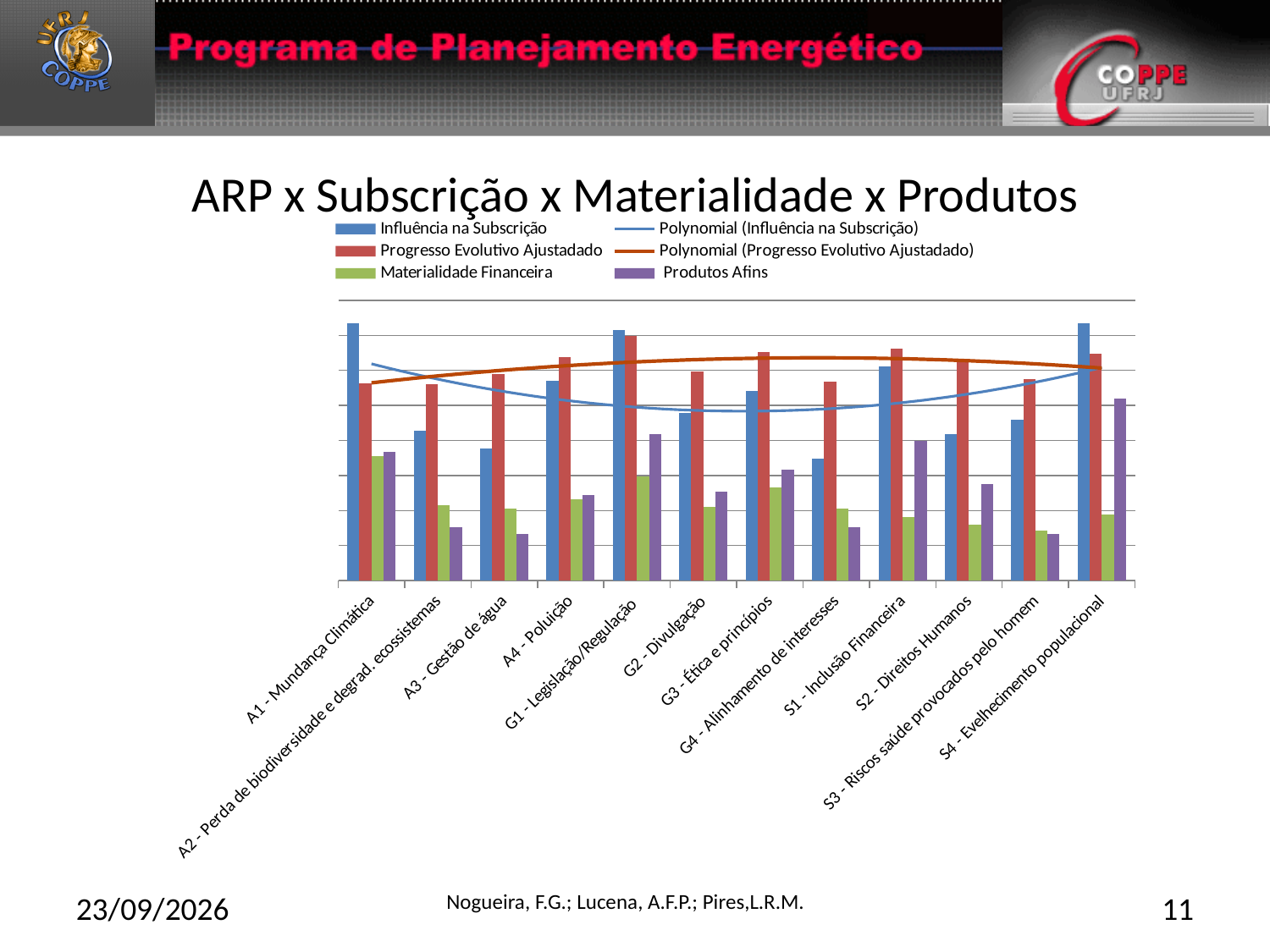
Which category has the highest value for Materialidade Financeira? A1 - Mundança Climática For A1 - Mundança Climática, which is larger: Influência na Subscrição or Progresso Evolutivo Ajustado? Influência na Subscrição For G2 - Divulgação, which is larger: Influência na Subscrição or Progresso Evolutivo Ajustado? Progresso Evolutivo Ajustado How many entries does the chart legend list? 6 How many categories are shown along the x axis of the chart? 12 Which category has the highest value for Produtos Afins? S4 - Evelhecimento populacional For S4 - Evelhecimento populacional, which is larger: Materialidade Financeira or Produtos Afins? Produtos Afins Which colour represents the Materialidade Financeira series in the chart? Green Does the Polynomial (Influência na Subscrição) line rise or fall from A1 - Mundança Climática to G2 - Divulgação? Fall What is the title of the chart? ARP x Subscrição x Materialidade x Produtos Which category has the highest value for Progresso Evolutivo Ajustado? G1 - Legislação/Regulação What kind of chart is shown on the slide? Bar chart